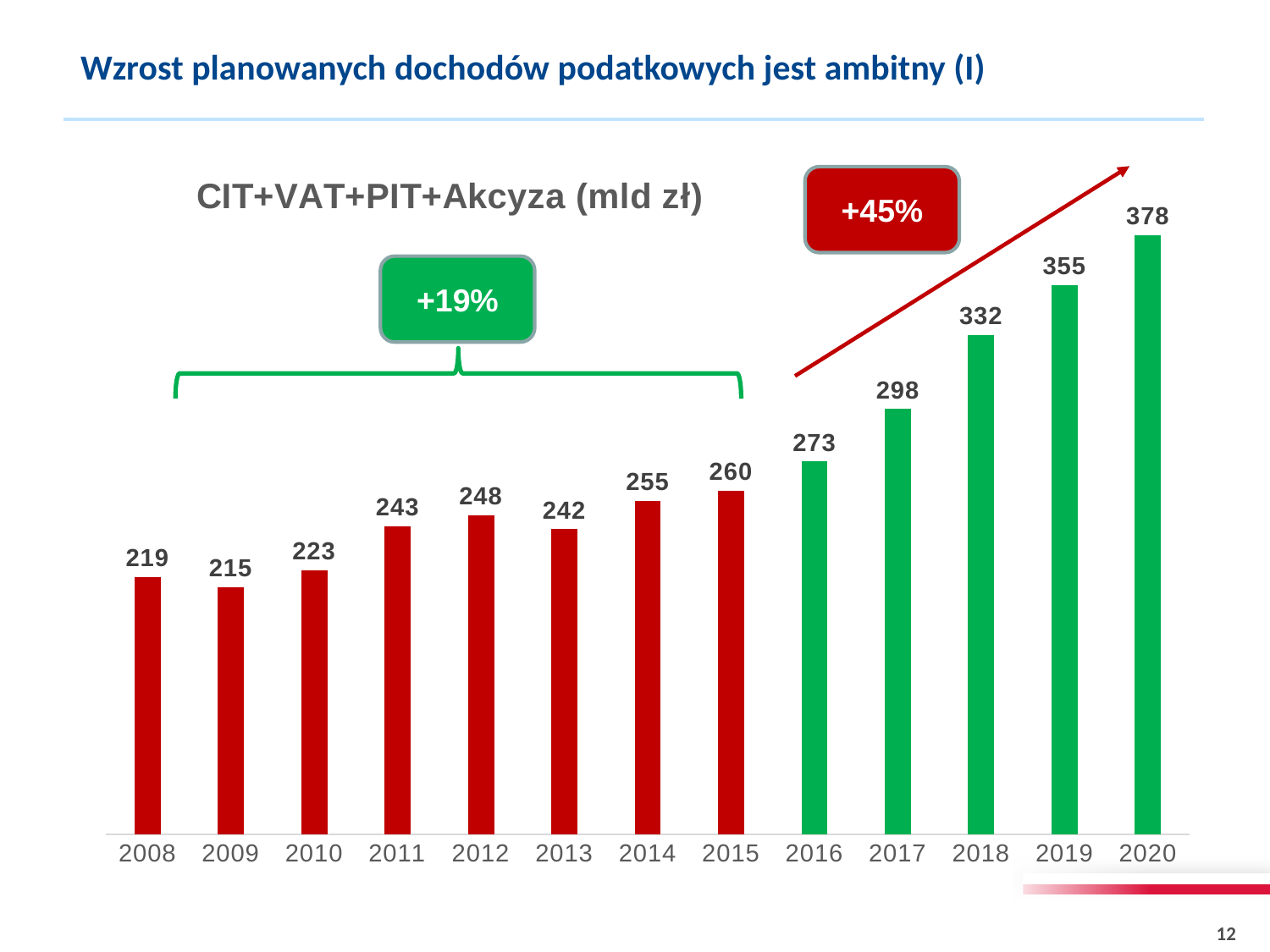
What is the value for 2008? 219 Which year has the highest value? 2020 What is the title of the chart? CIT+VAT+PIT+Akcyza (mld zł) Which is larger, the value for 2011 or the value for 2013? 2011 What is the difference between the values for 2020 and 2015? 118 What is the value for 2020? 378 What is the value for 2016? 273 Do the values generally rise or fall from 2015 to 2020? rise How many years are shown on the x axis? 13 What is the difference between the values for 2012 and 2013? 6 What kind of chart is this? bar chart Which year has the lowest value? 2009